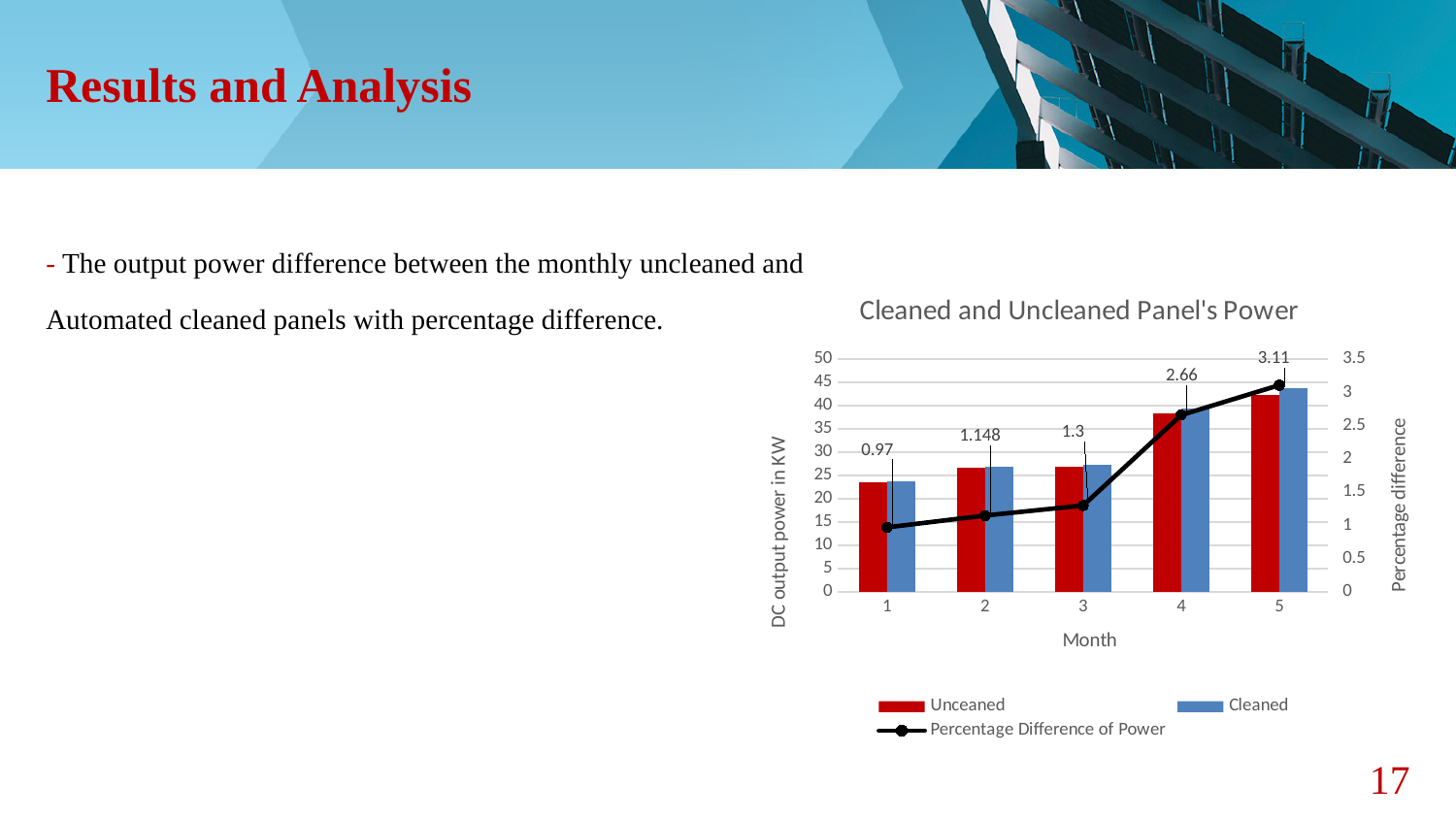
Is the Unceaned DC output power for month 4 greater or less than 30? greater Is the Cleaned DC output power for month 1 greater or less than 30? less How many series does the legend list? 3 What is the Percentage Difference of Power value for month 4? 2.66 Does the Percentage Difference of Power line rise or fall from month 1 to month 5? Rises What is the Percentage Difference of Power value for month 5? 3.11 How many months are shown on the x axis? 5 What is the difference between the Percentage Difference of Power values for month 5 and month 1? 2.14 Which month has the highest Percentage Difference of Power? 5 What is the Percentage Difference of Power value for month 1? 0.97 Is the Percentage Difference of Power larger in month 4 or month 2? Month 4 Which month has the lowest Percentage Difference of Power? 1